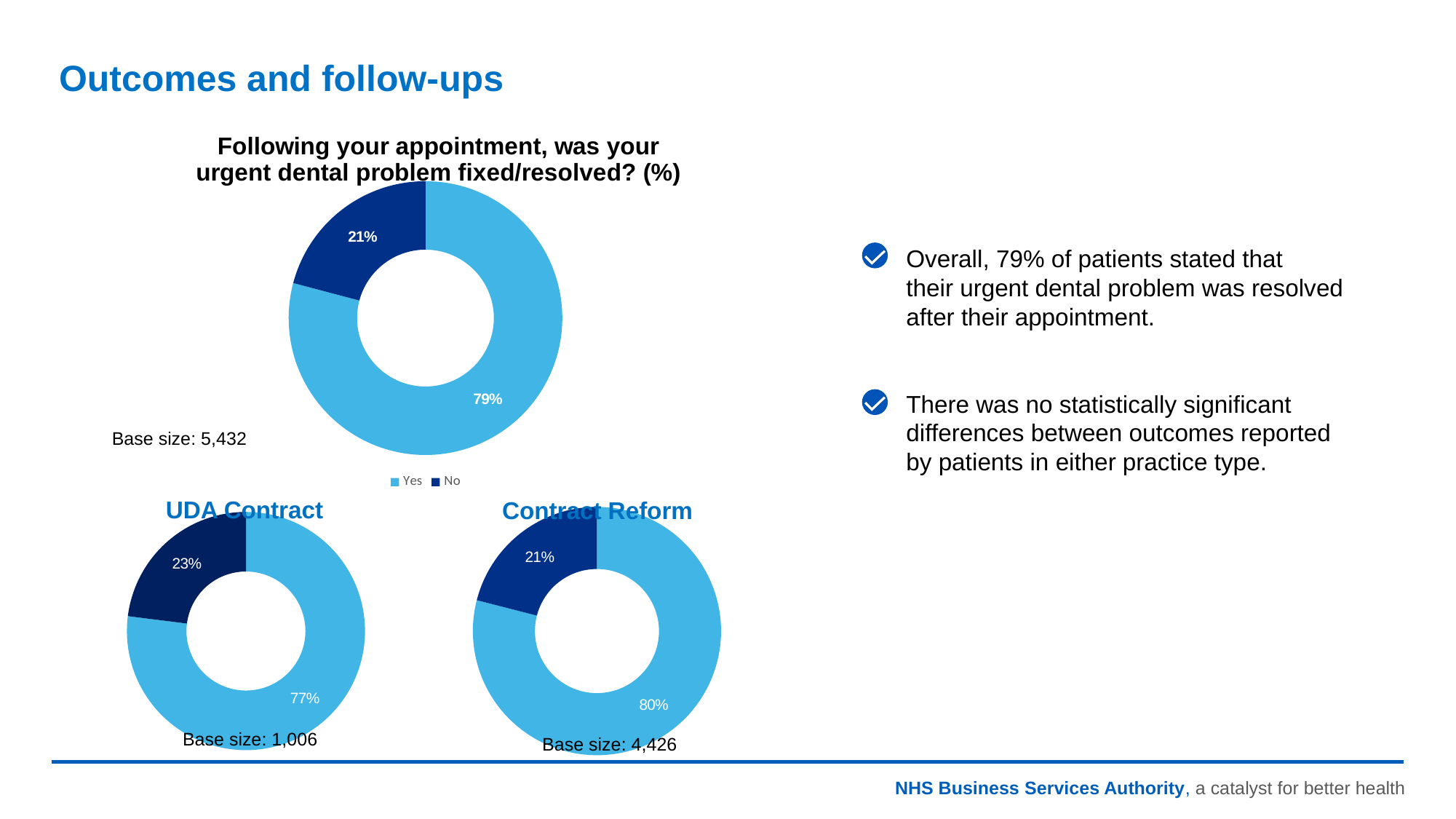
What is the base size shown for the UDA Contract chart? 1,006 In the UDA Contract chart, what percentage answered No? 23% In the top chart, which response has the larger share, Yes or No? Yes In the Contract Reform chart, what percentage answered No? 21% In the UDA Contract chart, what is the difference between the Yes and No percentages? 54% How many entries does the legend of the top chart list? 2 What type of chart is the top chart titled 'Following your appointment, was your urgent dental problem fixed/resolved? (%)'? Doughnut (pie) chart In the top chart titled 'Following your appointment, was your urgent dental problem fixed/resolved? (%)', what percentage answered No? 21% In the Contract Reform chart, what percentage answered Yes? 80% In the top chart titled 'Following your appointment, was your urgent dental problem fixed/resolved? (%)', what percentage answered Yes? 79% In the UDA Contract chart, what percentage answered Yes? 77% Which chart shows the higher Yes percentage, UDA Contract or Contract Reform? Contract Reform